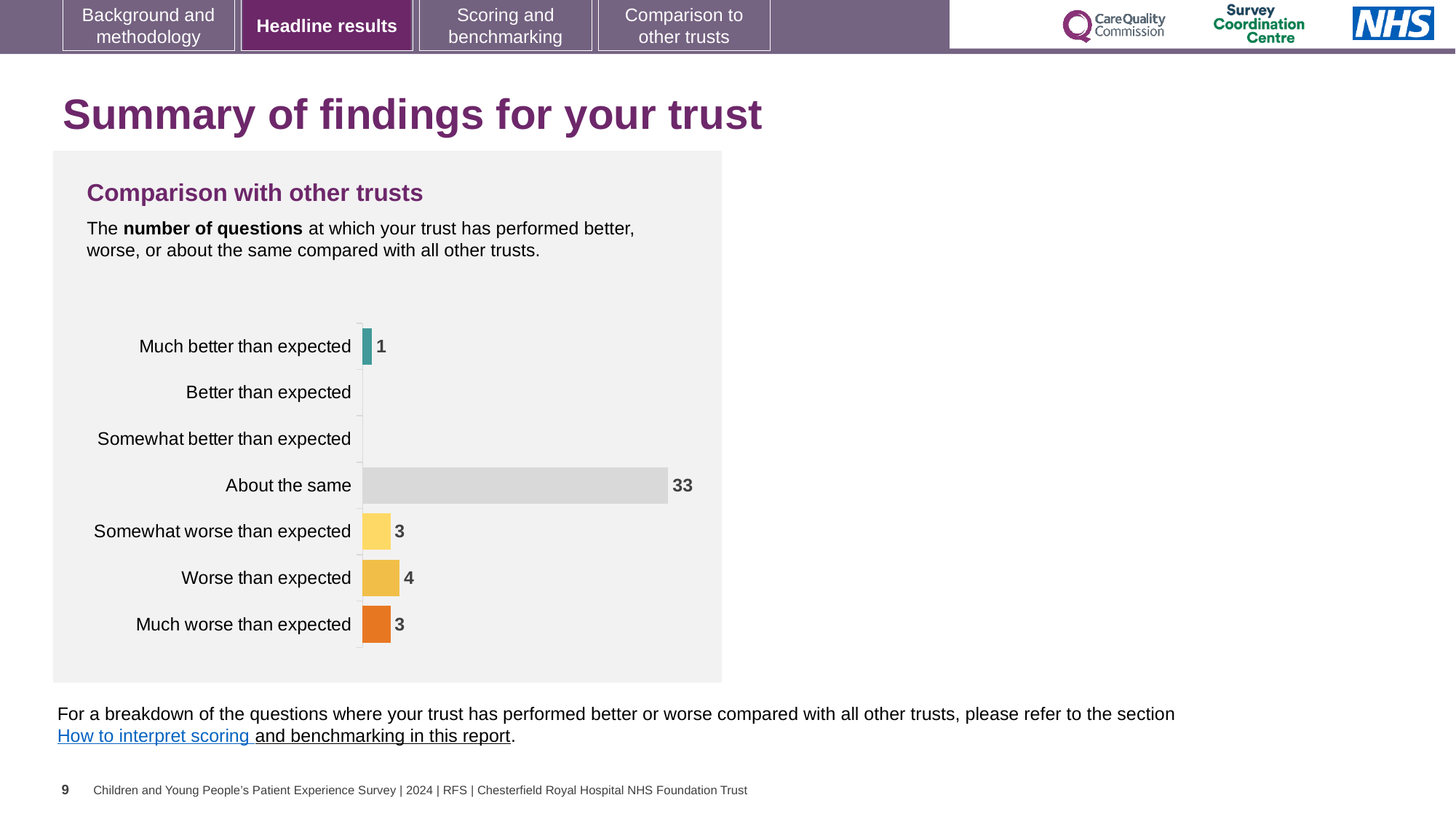
What is the value for 'Much worse than expected'? 3 Which category has the highest number of questions? About the same What is the value for 'Somewhat worse than expected'? 3 What kind of chart is shown on the slide? Bar chart What is the difference between 'About the same' and 'Worse than expected'? 29 Which is larger: 'Worse than expected' or 'Somewhat worse than expected'? Worse than expected How many categories are shown on the chart? 7 How many questions were rated 'About the same'? 33 What is the title of the chart? Comparison with other trusts What is the value for 'Much better than expected'? 1 What is the difference between 'Worse than expected' and 'Much better than expected'? 3 What is the value for 'Worse than expected'? 4